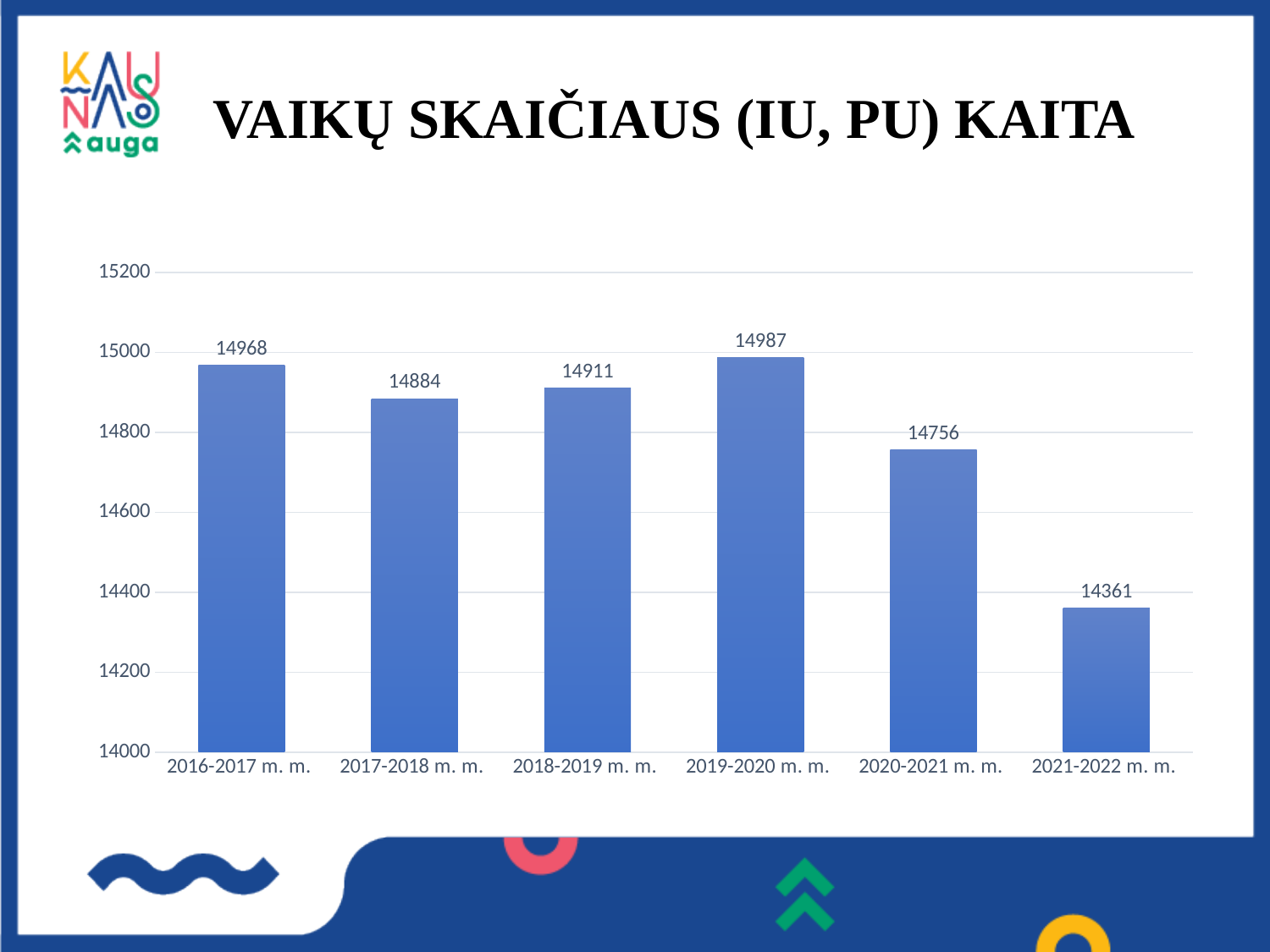
What kind of chart is shown on the slide? bar chart How many school years are shown on the chart? 6 What is the value for 2021-2022 m. m.? 14361 What is the difference between the values for 2019-2020 m. m. and 2021-2022 m. m.? 626 What is the value for 2020-2021 m. m.? 14756 Which is larger, the value for 2018-2019 m. m. or the value for 2020-2021 m. m.? 2018-2019 m. m. What is the difference between the values for 2016-2017 m. m. and 2017-2018 m. m.? 84 What is the title of the slide? VAIKŲ SKAIČIAUS (IU, PU) KAITA Is the value for 2021-2022 m. m. greater or less than 14400? less Which school year has the lowest value? 2021-2022 m. m. Which school year has the highest value? 2019-2020 m. m. What is the value for 2016-2017 m. m.? 14968